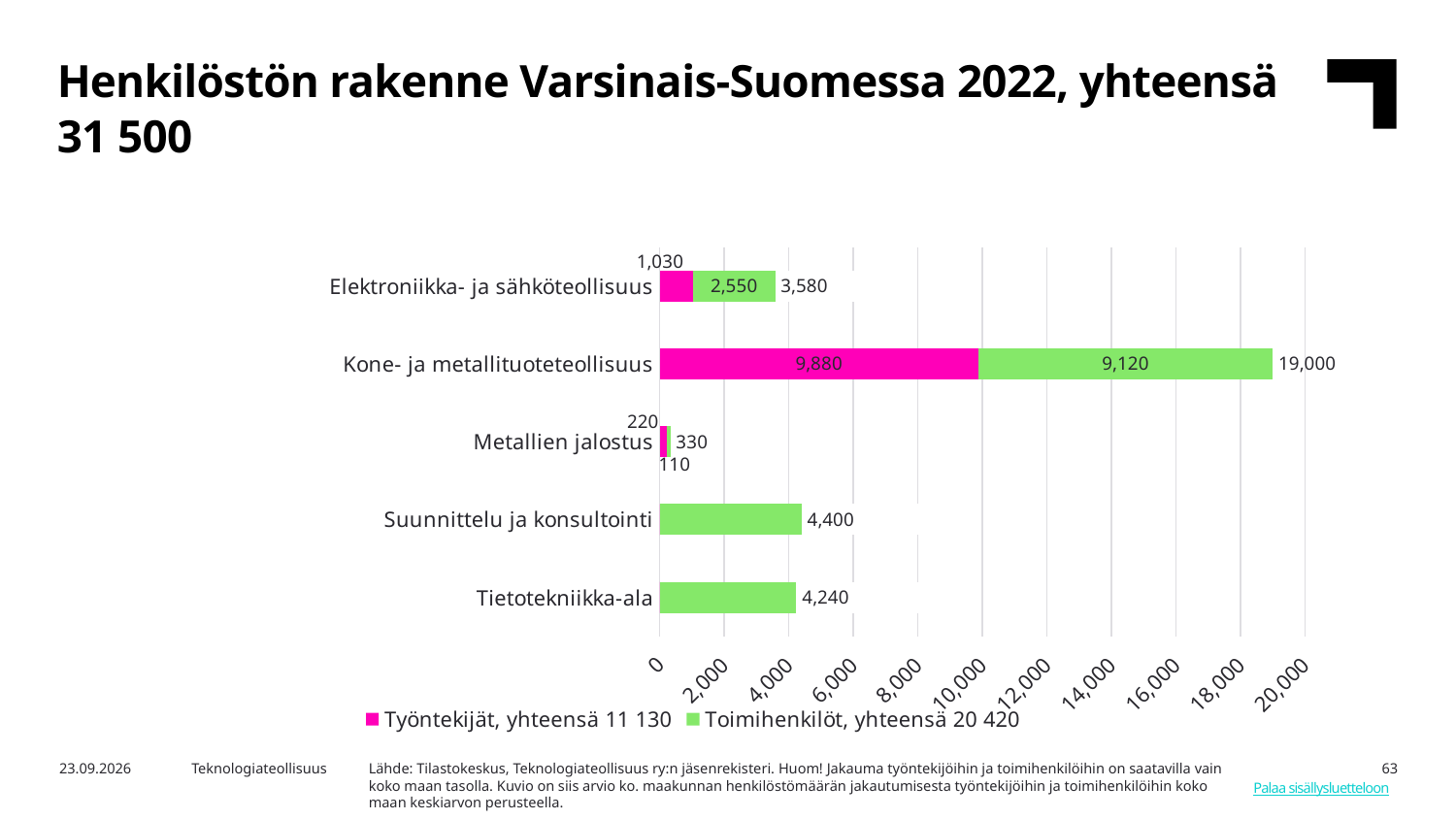
What is the Työntekijät value for Kone- ja metallituoteteollisuus? 9,880 What is the total shown for the Kone- ja metallituoteteollisuus bar? 19,000 How many categories are shown on the chart? 5 What is the total given in the legend for Toimihenkilöt? 20 420 Which category has the highest total? Kone- ja metallituoteteollisuus Which is larger: the Työntekijät value or the Toimihenkilöt value for Kone- ja metallituoteteollisuus? Työntekijät Which category has the lowest total? Metallien jalostus What is the difference between the totals for Suunnittelu ja konsultointi and Tietotekniikka-ala? 160 How many series does the legend list? 2 What kind of chart is shown on the slide? Stacked bar chart What is the Toimihenkilöt value for Elektroniikka- ja sähköteollisuus? 2,550 What is the total shown for the Metallien jalostus bar? 330